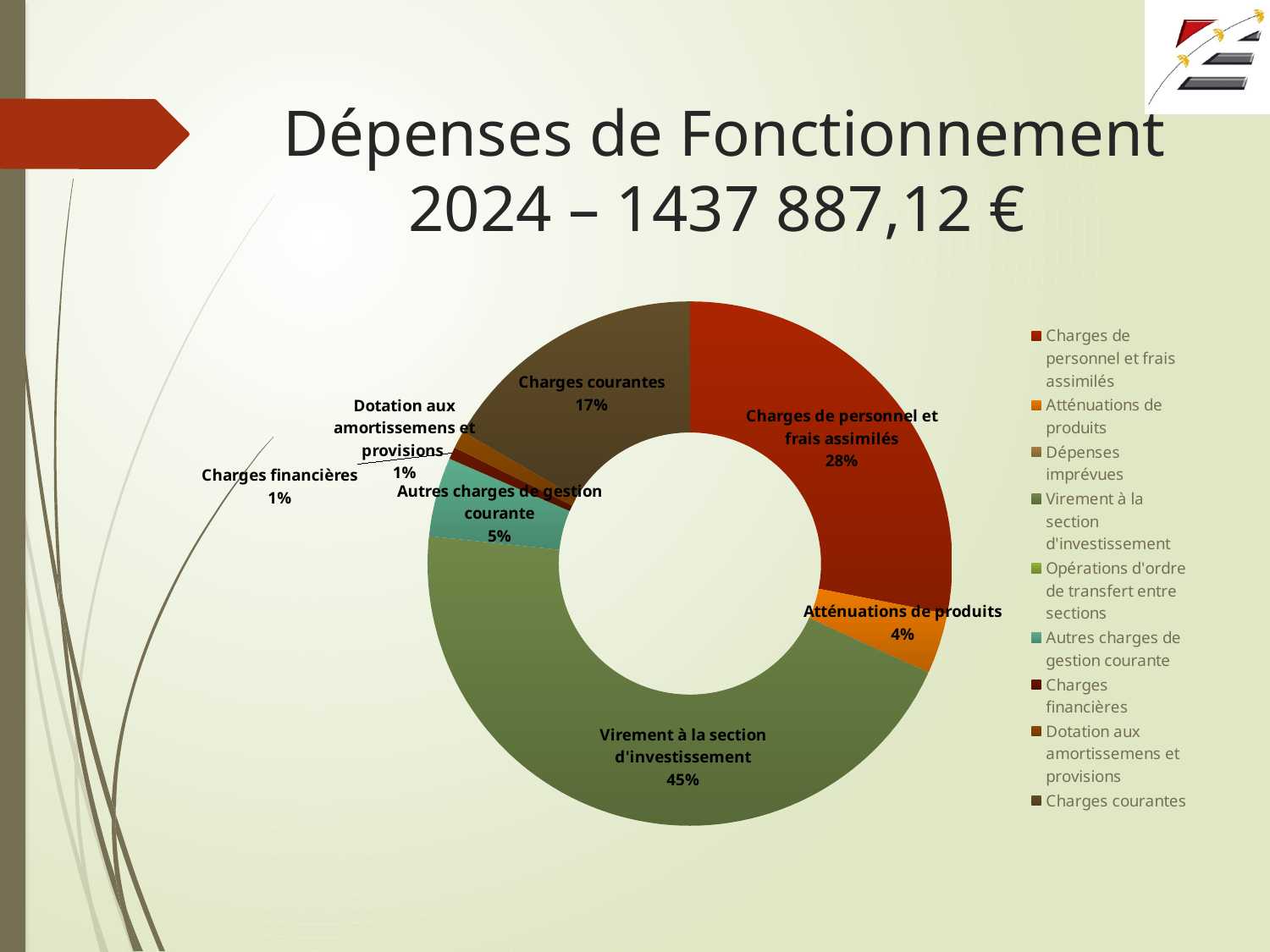
What percentage is shown for Autres charges de gestion courante? 5% What share of the doughnut chart is labelled for Virement à la section d'investissement? 45% What percentage is shown for Atténuations de produits? 4% What kind of chart is shown on the slide? Doughnut chart How many entries does the legend list? 9 What percentage is shown for Charges financières? 1% What percentage is shown for Charges courantes? 17% What percentage is shown for Charges de personnel et frais assimilés? 28% What is the difference in percentage points between Virement à la section d'investissement and Charges de personnel et frais assimilés? 17 What is the title of the slide containing the chart? Dépenses de Fonctionnement 2024 – 1437 887,12 € Which category has the largest share of the chart? Virement à la section d'investissement Which is larger, the share for Charges courantes or the share for Atténuations de produits? Charges courantes